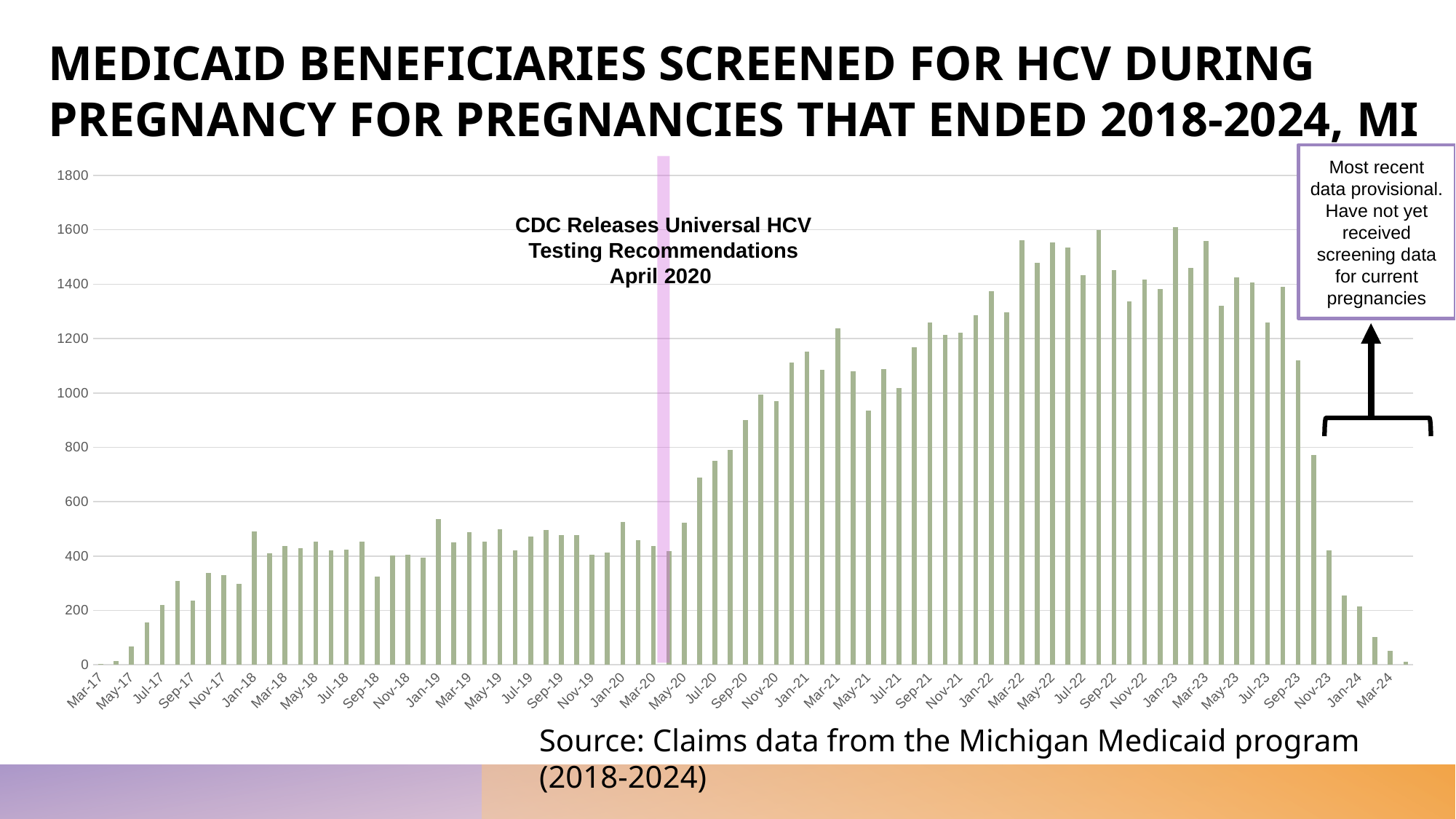
What event does the annotation in the middle of the chart mark, and in which month? CDC Releases Universal HCV Testing Recommendations, April 2020 Do the values generally rise or fall from May-20 to Mar-22? rise Is the value for Sep-21 greater or less than 1000? greater Is the value for Mar-24 greater or less than 200? less Do the values rise or fall from Sep-23 to Mar-24? fall Is the value for Mar-17 greater or less than 200? less Which is larger, the value for Sep-19 or the value for Sep-21? Sep-21 What kind of chart is shown on the slide? bar chart Which is larger, the value for Jan-23 or the value for Mar-17? Jan-23